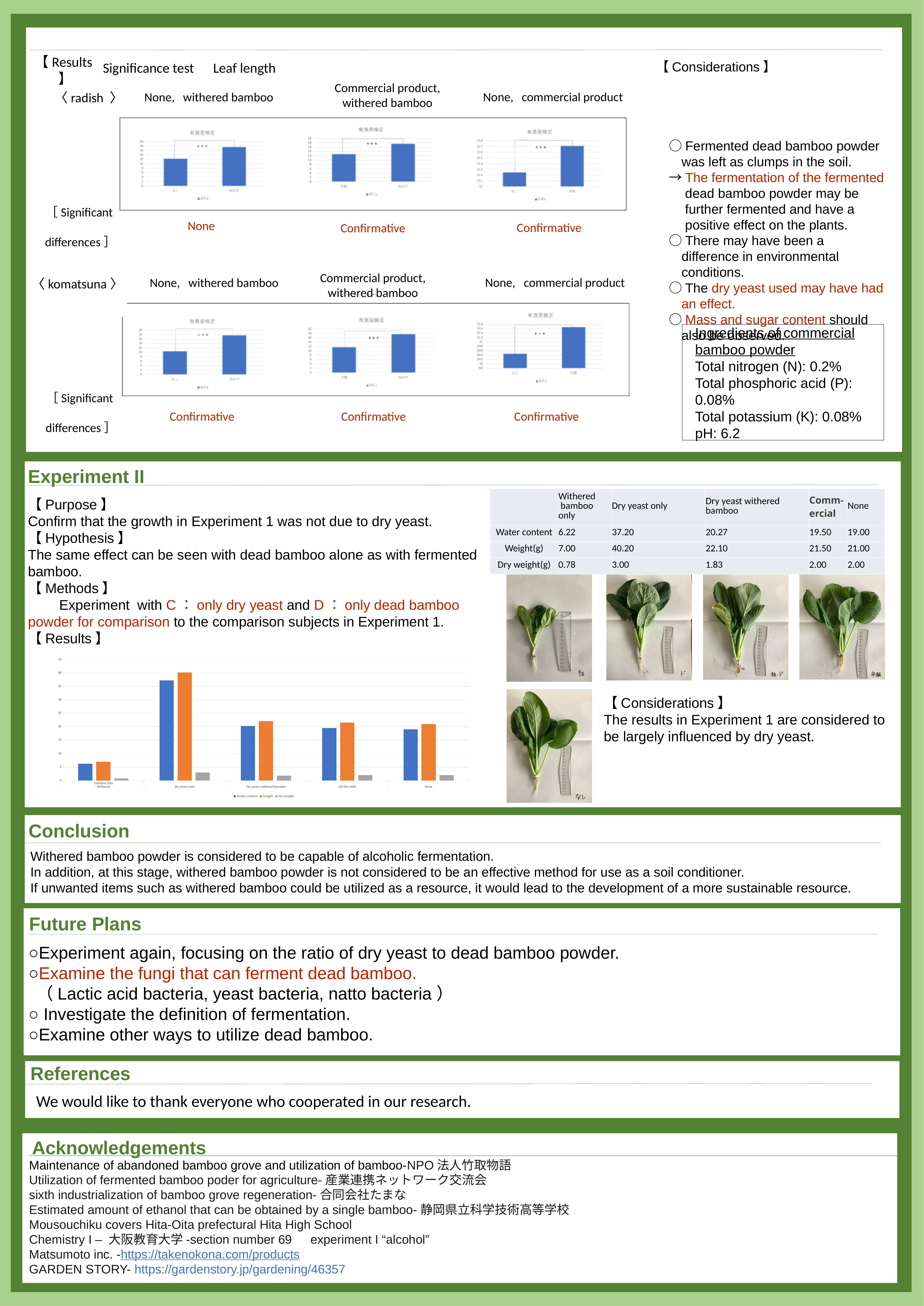
In the Experiment II Results bar chart, which has the larger weight bar: Dry yeast only or None? Dry yeast only In the Experiment II Results bar chart, is the weight value for Withered bamboo only greater or less than 10? less In the Experiment II Results bar chart, is the Water content value for Dry yeast only greater or less than 30? greater In the Experiment II Results bar chart, which category has the highest Water content bar? Dry yeast only What kind of chart is shown under Results in the Experiment II section? bar chart What are the three legend entries of the Experiment II Results bar chart? Water content, weight, Dry weight According to the Experiment II table, what is the Water content value for Dry yeast only? 37.20 In the Experiment II Results bar chart, which category has the lowest weight bar? Withered bamboo only How many series does the legend of the Experiment II Results bar chart list? 3 According to the Experiment II table, what is the Weight(g) value for Dry yeast withered bamboo? 22.10 How many categories are shown along the x axis of the Experiment II Results bar chart? 5 In the Experiment II Results bar chart, is the Dry weight value for Dry yeast only greater or less than 5? less